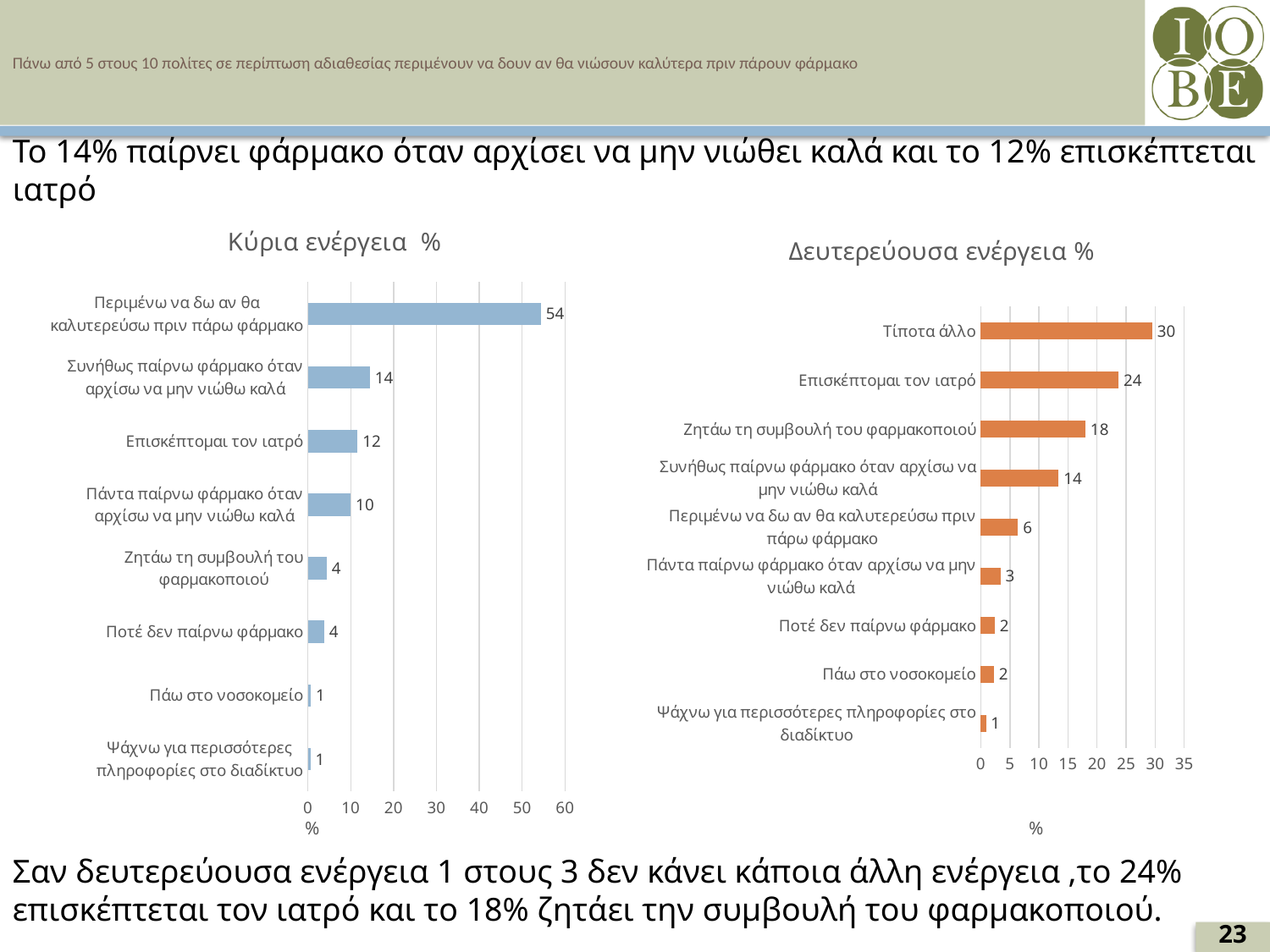
In the 'Κύρια ενέργεια %' chart, what is the difference between 'Συνήθως παίρνω φάρμακο όταν αρχίσω να μην νιώθω καλά' and 'Πάντα παίρνω φάρμακο όταν αρχίσω να μην νιώθω καλά'? 4 In the 'Δευτερεύουσα ενέργεια %' chart, which category has the lowest value? Ψάχνω για περισσότερες πληροφορίες στο διαδίκτυο In the 'Δευτερεύουσα ενέργεια %' chart, which category has the highest value? Τίποτα άλλο In the 'Κύρια ενέργεια %' chart, what is the value for 'Περιμένω να δω αν θα καλυτερεύσω πριν πάρω φάρμακο'? 54 In the 'Δευτερεύουσα ενέργεια %' chart, what is the value for 'Ζητάω τη συμβουλή του φαρμακοποιού'? 18 In the 'Δευτερεύουσα ενέργεια %' chart, which is larger: 'Επισκέπτομαι τον ιατρό' or 'Συνήθως παίρνω φάρμακο όταν αρχίσω να μην νιώθω καλά'? Επισκέπτομαι τον ιατρό What type of chart is the 'Δευτερεύουσα ενέργεια %' chart? Bar chart In the 'Δευτερεύουσα ενέργεια %' chart, what is the difference between 'Τίποτα άλλο' and 'Επισκέπτομαι τον ιατρό'? 6 In the 'Κύρια ενέργεια %' chart, which category has the highest value? Περιμένω να δω αν θα καλυτερεύσω πριν πάρω φάρμακο In the 'Κύρια ενέργεια %' chart, what is the value for 'Επισκέπτομαι τον ιατρό'? 12 How many categories are shown in the 'Δευτερεύουσα ενέργεια %' chart? 9 How many categories are shown in the 'Κύρια ενέργεια %' chart? 8